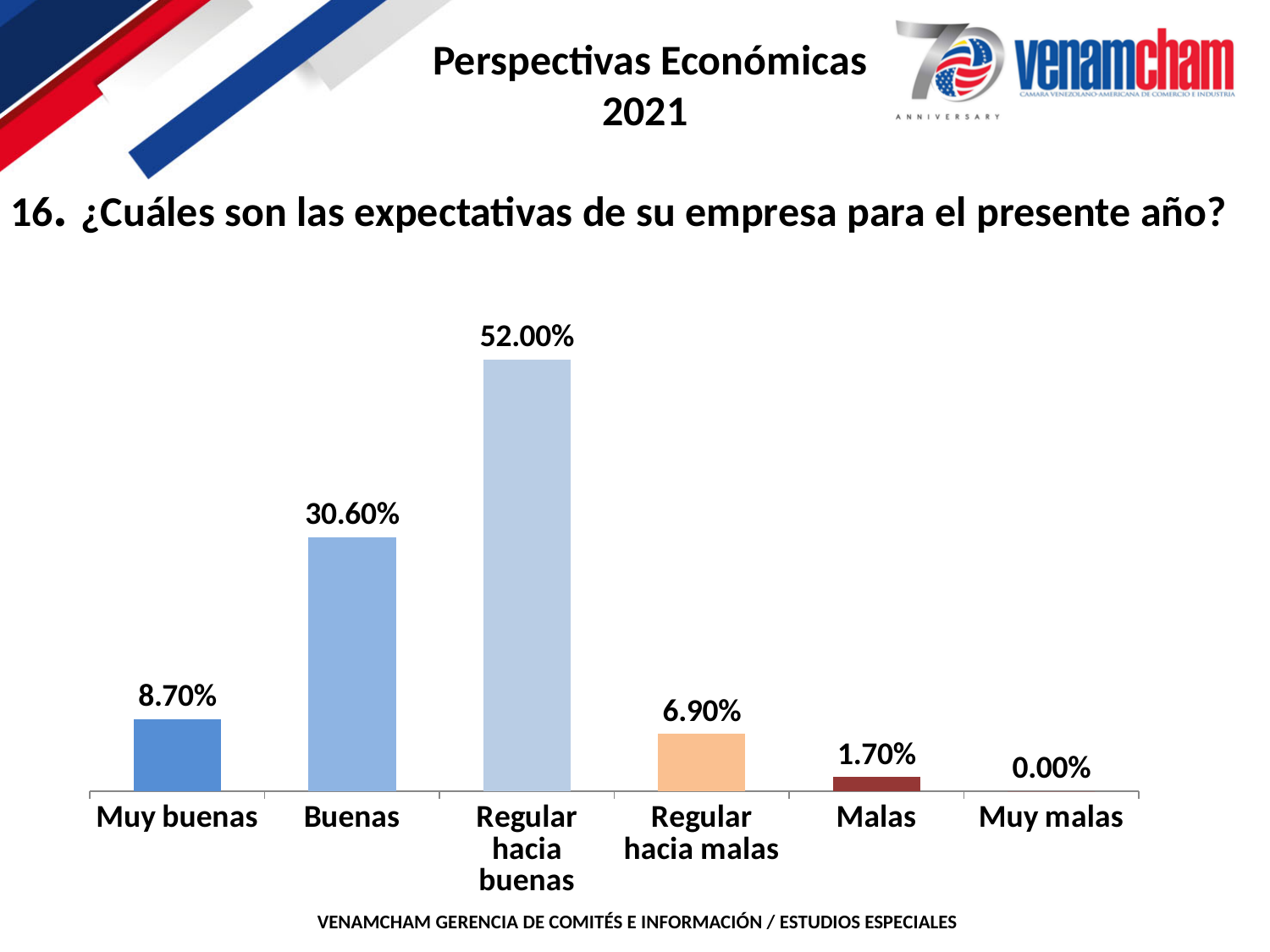
What is the value for "Buenas"? 30.60% What is the difference between the values for "Regular hacia buenas" and "Buenas"? 21.40% What kind of chart is shown on the slide? Bar chart What is the value for "Muy malas"? 0.00% What is the difference between the values for "Muy buenas" and "Regular hacia malas"? 1.80% What is the value for "Regular hacia buenas"? 52.00% Which category has the lowest value? Muy malas Which category has the highest value? Regular hacia buenas Which is larger, the value for "Muy buenas" or the value for "Regular hacia malas"? Muy buenas What is the value for "Muy buenas"? 8.70% What is the value for "Malas"? 1.70% How many categories are shown on the chart? 6